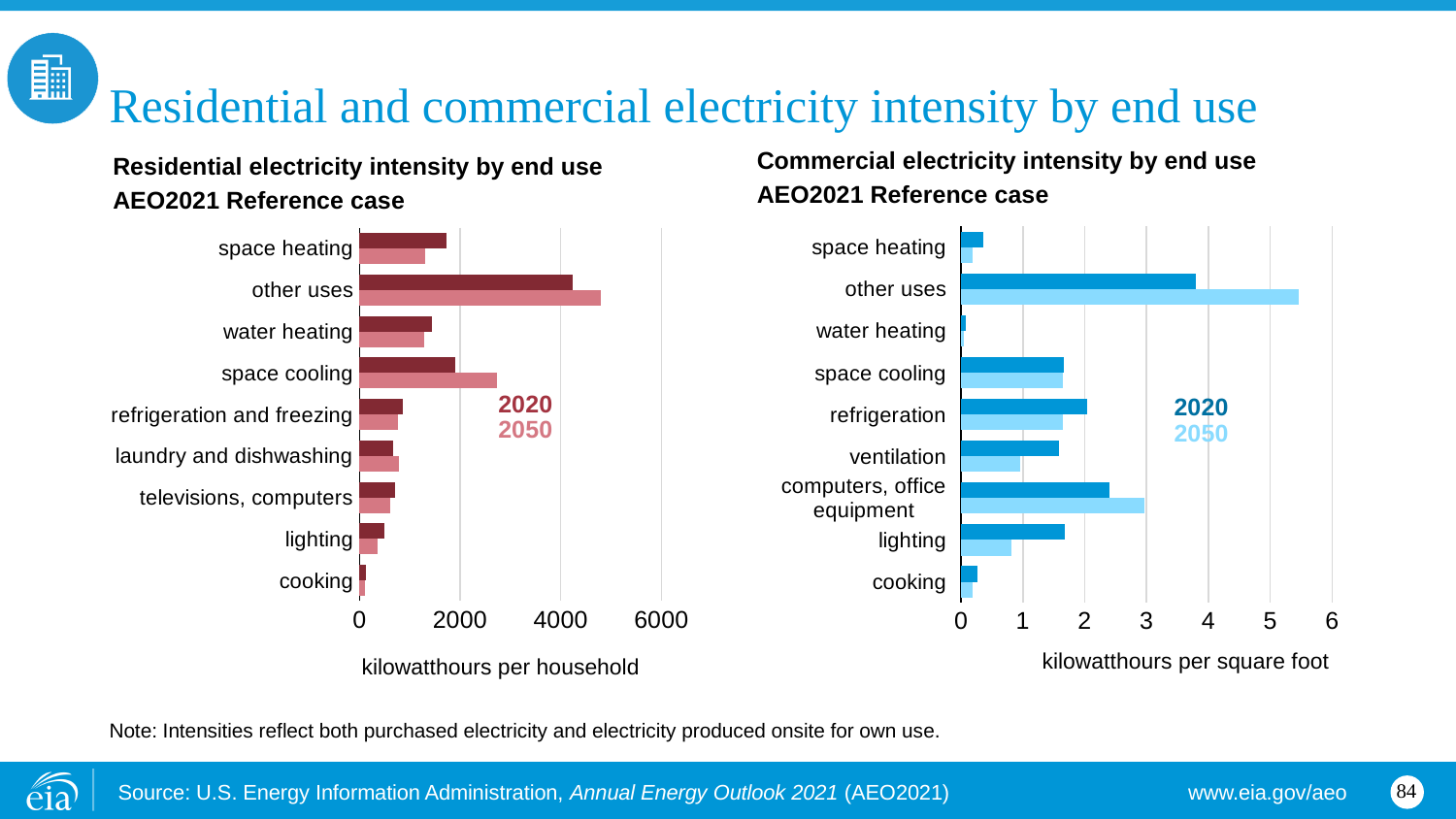
How many end-use categories are shown in the Commercial electricity intensity by end use chart? 9 In the Commercial electricity intensity by end use chart, is the 2050 value for other uses greater or less than 5? greater In the Commercial electricity intensity by end use chart, which end use has the highest 2020 value? other uses What unit is shown on the x axis of the Commercial electricity intensity by end use chart? kilowatthours per square foot In the Commercial electricity intensity by end use chart, which is larger for computers, office equipment: the 2020 value or the 2050 value? 2050 In the Residential electricity intensity by end use chart, which end use has the highest 2050 value? other uses How many series does the legend list in the Residential electricity intensity by end use chart? 2 In the Residential electricity intensity by end use chart, which end use has the lowest 2020 value? cooking What kind of chart is the Residential electricity intensity by end use chart? bar chart In the Commercial electricity intensity by end use chart, which end use has the lowest 2020 value? water heating In the Residential electricity intensity by end use chart, is the 2050 value for other uses greater or less than 4000? greater